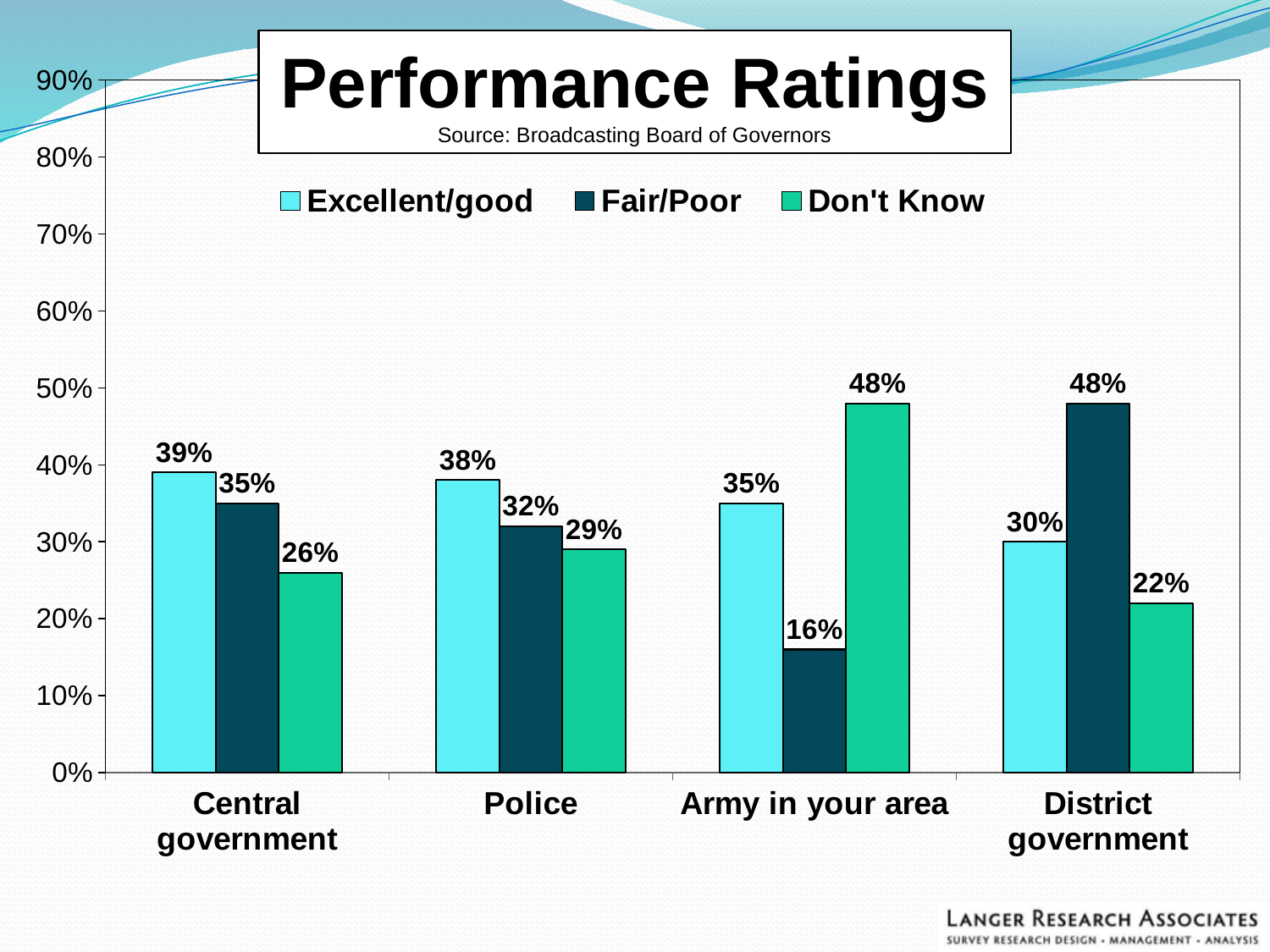
What is the Excellent/good rating for Central government? 39% Which is larger for Police: the Excellent/good rating or the Fair/Poor rating? Excellent/good What kind of chart is shown on the slide? Bar chart How many series does the legend list? 3 What is the Don't Know value for District government? 22% What is the difference between the Don't Know and Fair/Poor values for Army in your area? 32% Which category has the highest Fair/Poor rating? District government How many categories are shown on the x axis? 4 Which category has the lowest Excellent/good rating? District government What is the Fair/Poor rating for Army in your area? 16% What is the source cited under the chart title? Broadcasting Board of Governors Is the Don't Know value for Central government greater or less than 30%? less